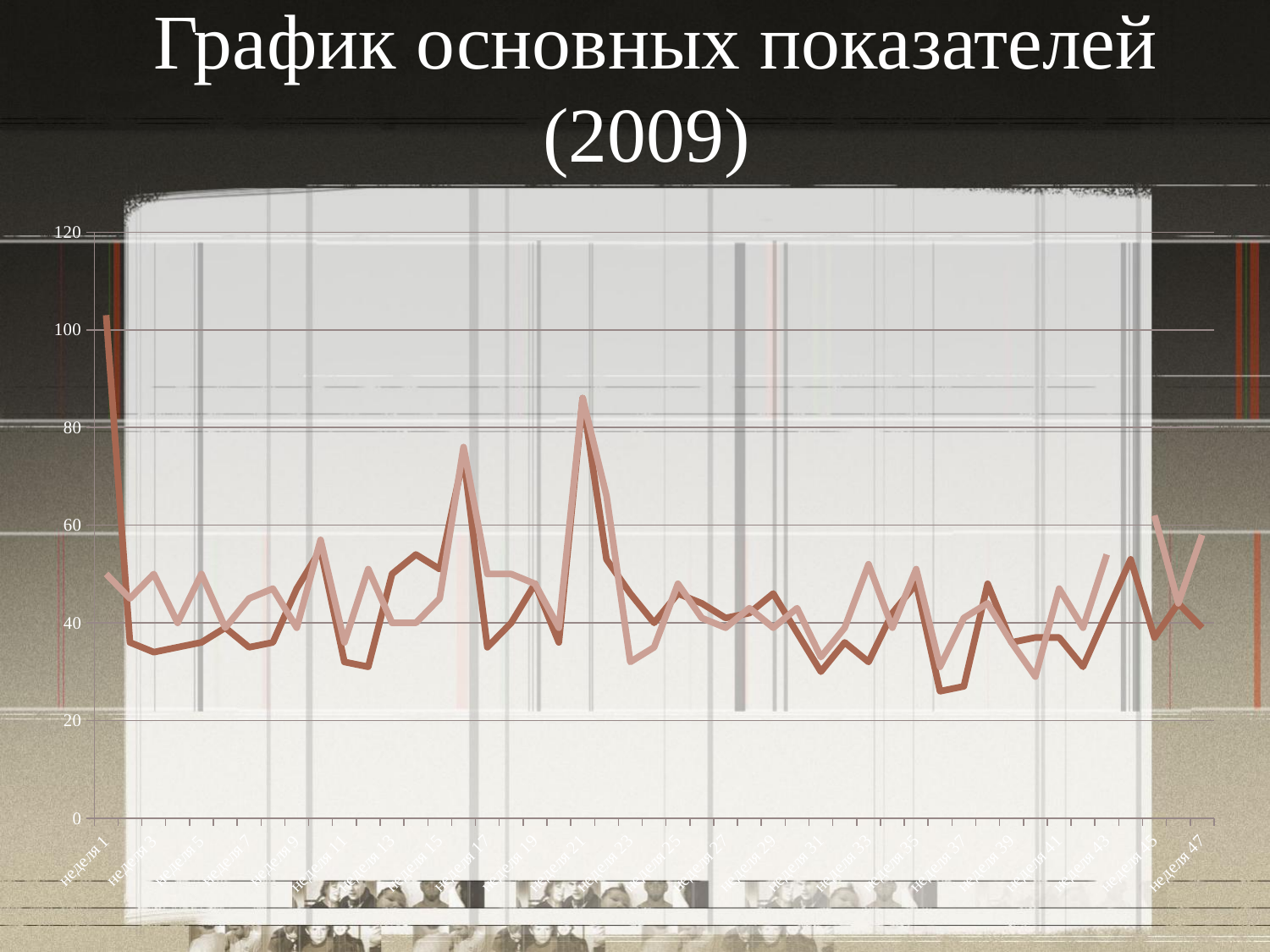
At which week does the lighter pink line reach its highest value? неделя 21 Is the value of the darker brown line at неделя 37 greater or less than 40? less How many lines are plotted on the chart? 2 Is the value of the darker brown line at неделя 1 greater or less than 80? greater What is the highest value shown on the vertical axis? 120 At неделя 1, which line has the larger value, the darker brown line or the lighter pink line? the darker brown line What is the title of the chart? График основных показателей (2009) Does the darker brown line overall rise or fall from неделя 1 to неделя 47? fall How many week labels are shown along the horizontal axis? 24 Is the value of the lighter pink line at неделя 21 greater or less than 80? greater What kind of chart is shown on the slide? line chart At which week does the darker brown line reach its highest value? неделя 1